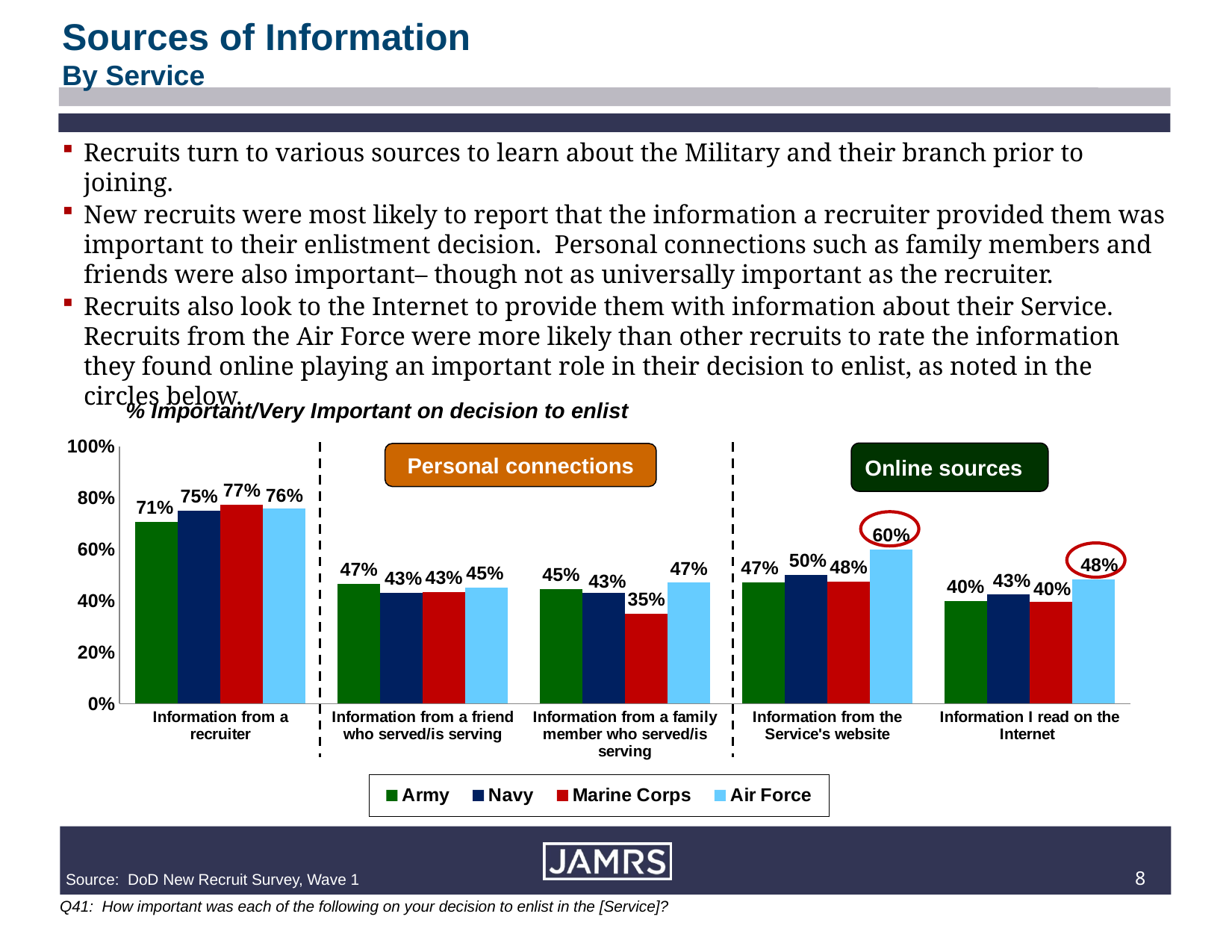
Which Service has the highest value for 'Information from a recruiter'? Marine Corps What is the value for Army for 'Information from a recruiter'? 71% How many series does the legend list? 4 What is the value for Marine Corps for 'Information from a family member who served/is serving'? 35% Which Service has the lowest value for 'Information from a family member who served/is serving'? Marine Corps What is the difference between the Air Force and Army values for 'Information from the Service's website'? 13% What is the difference between the Marine Corps and Army values for 'Information from a recruiter'? 6% How many categories of information sources are shown on the x axis? 5 What kind of chart is shown on the slide? Bar chart What percentage of Air Force recruits rated information from the Service's website as important/very important? 60% For 'Information I read on the Internet', which is larger: the Navy value or the Air Force value? Air Force Which two categories are grouped under the 'Online sources' label? Information from the Service's website; Information I read on the Internet